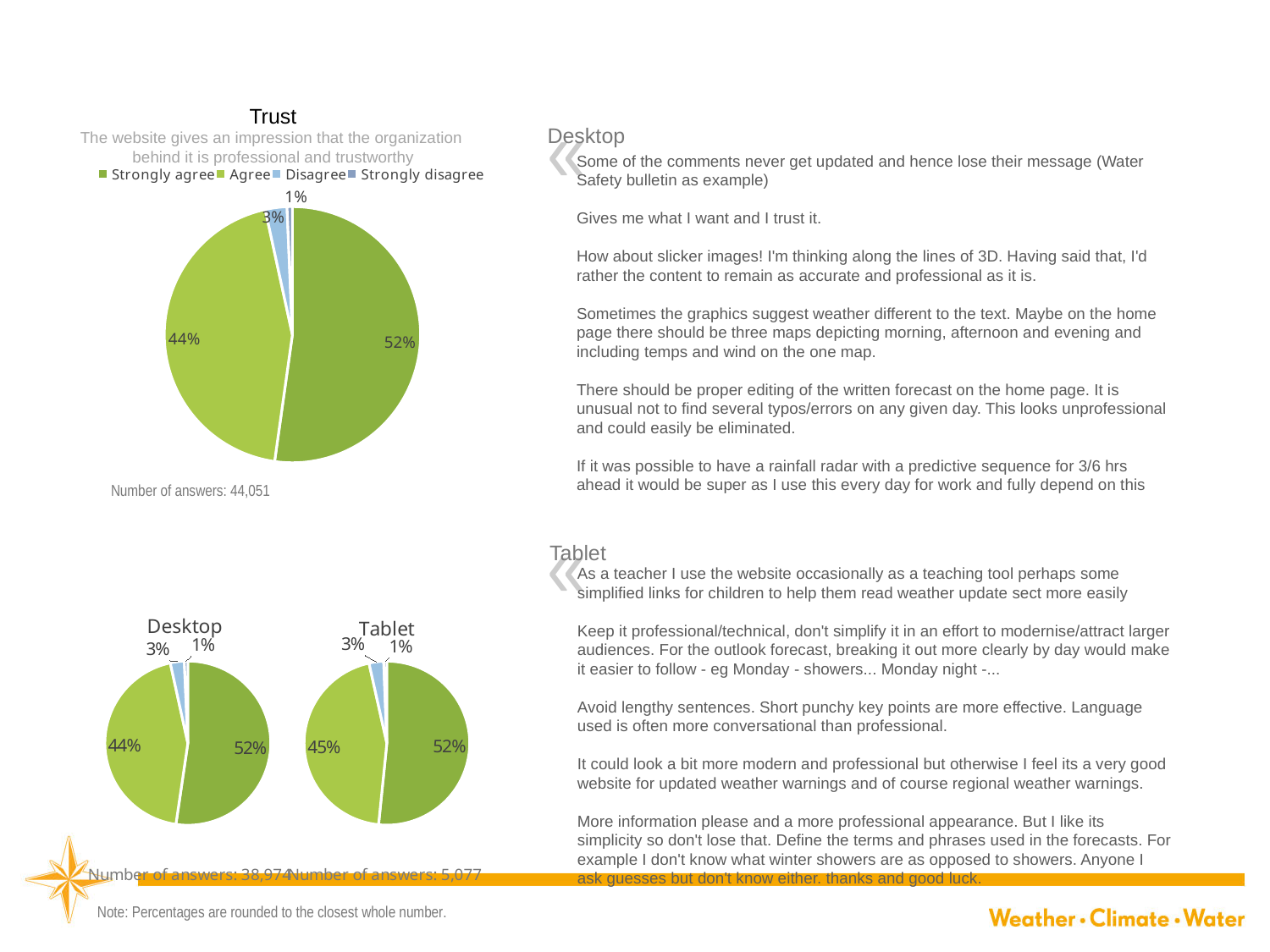
In the Tablet pie chart, what percentage of respondents agree? 45% How many response categories does the legend of the Trust chart list? 4 In the Trust pie chart, what percentage of respondents strongly agree? 52% In the Trust pie chart, what percentage of respondents agree? 44% In the Trust pie chart, what is the difference between the Strongly agree and Agree shares? 8% In the Desktop pie chart, what percentage of respondents strongly agree? 52% Which is larger: the Agree share in the Desktop pie chart or the Agree share in the Tablet pie chart? Tablet What type of chart is used to show the Trust results? Pie chart In the Trust pie chart, what percentage of respondents disagree? 3% In the Trust pie chart, which response category has the smallest share? Strongly disagree How many pie charts are shown on the slide? 3 In the Trust pie chart, which response category has the largest share? Strongly agree